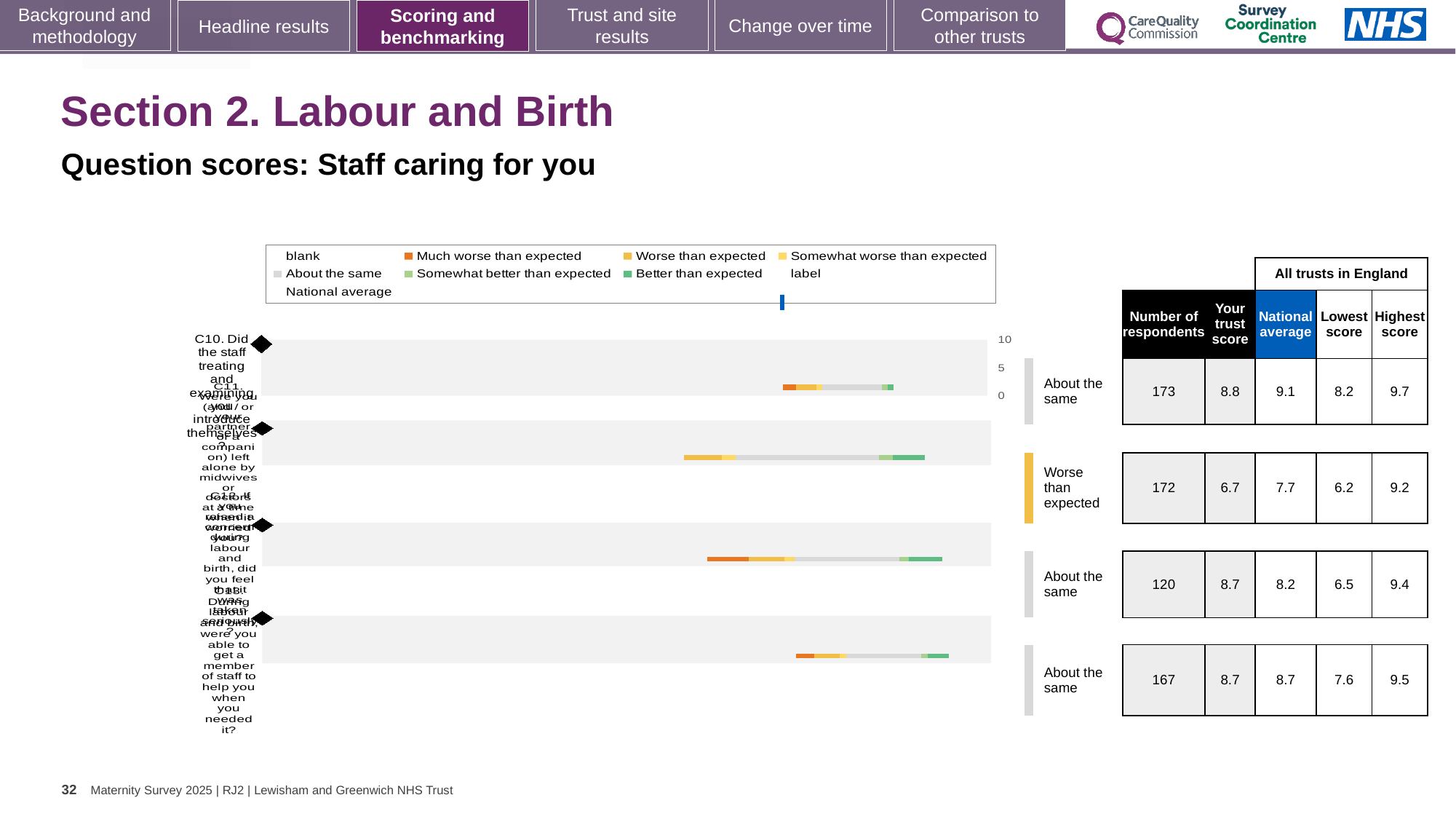
For the row rated 'Worse than expected', what is the difference between the national average and your trust score? 1.0 What type of chart is used to show the question scores on this slide? bar chart Which row has the lowest 'Your trust score'? the second row, 6.7 How many rows are rated 'About the same'? 3 How many questions (rows) are plotted in the chart? 4 What is the number of respondents for the first row (C10)? 173 Which colour in the legend represents 'Much worse than expected'? orange What is the lowest score among all trusts in England for the second row? 6.2 Which row has the highest 'Your trust score'? the first row (C10), 8.8 What is the 'Your trust score' for the row rated 'Worse than expected'? 6.7 What is the highest score among all trusts in England for the fourth row? 9.5 For the third row, which is larger: your trust score or the national average? Your trust score (8.7)